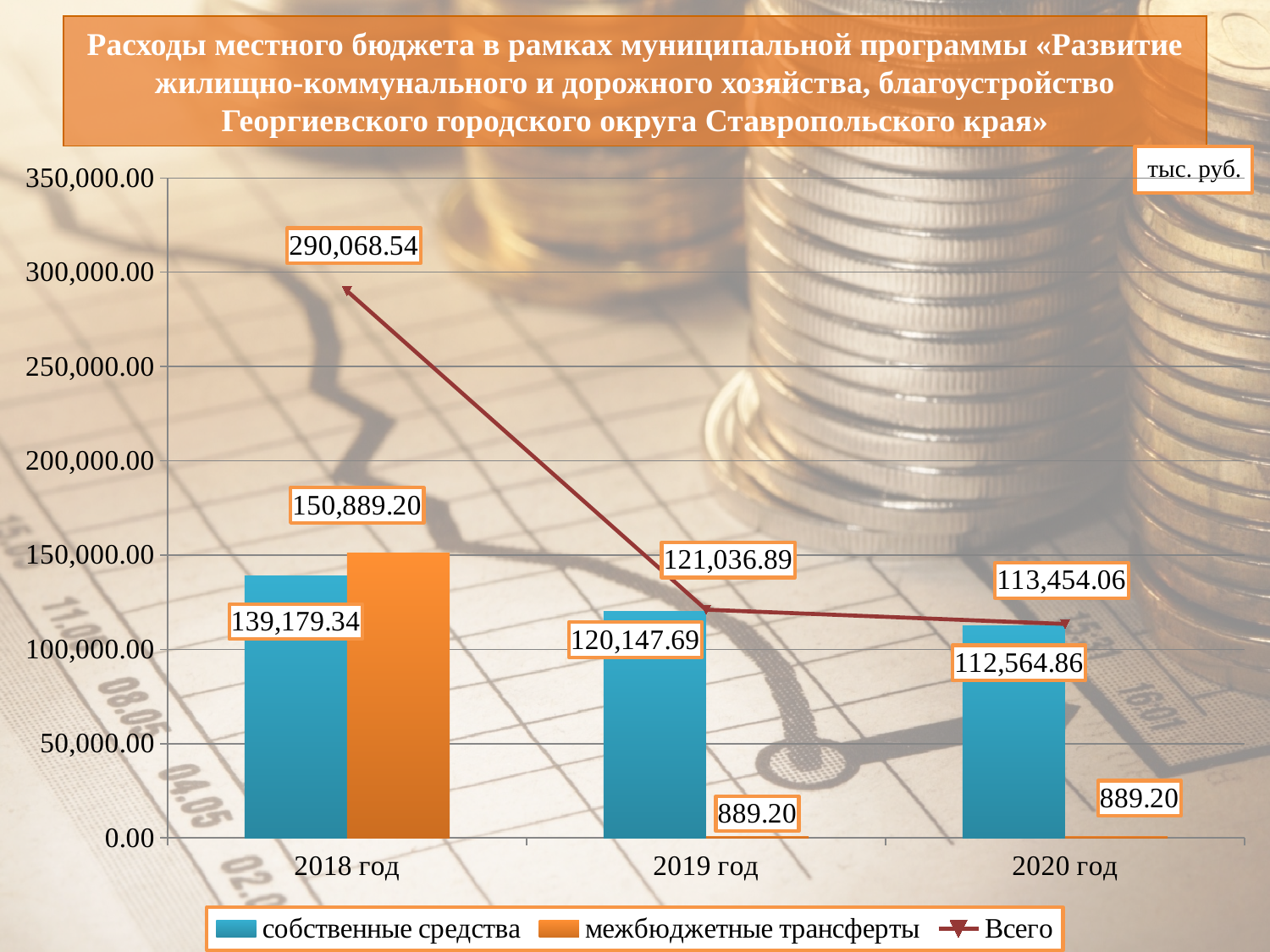
How many series does the legend list? 3 Does «Всего» rise or fall from 2018 год to 2020 год? fall How many years are shown on the x axis? 3 In which year is «Всего» the highest? 2018 год What is the difference between «Всего» for 2019 год and 2020 год? 7,582.83 In which year is «собственные средства» the lowest? 2020 год What is the value of «межбюджетные трансферты» for 2020 год? 889.20 What is the value of «собственные средства» for 2018 год? 139,179.34 What is the value of «Всего» for 2019 год? 121,036.89 Is the value of «собственные средства» for 2019 год greater or less than 100,000.00? greater What is the value of «межбюджетные трансферты» for 2018 год? 150,889.20 Which is larger in 2018 год: «собственные средства» or «межбюджетные трансферты»? межбюджетные трансферты